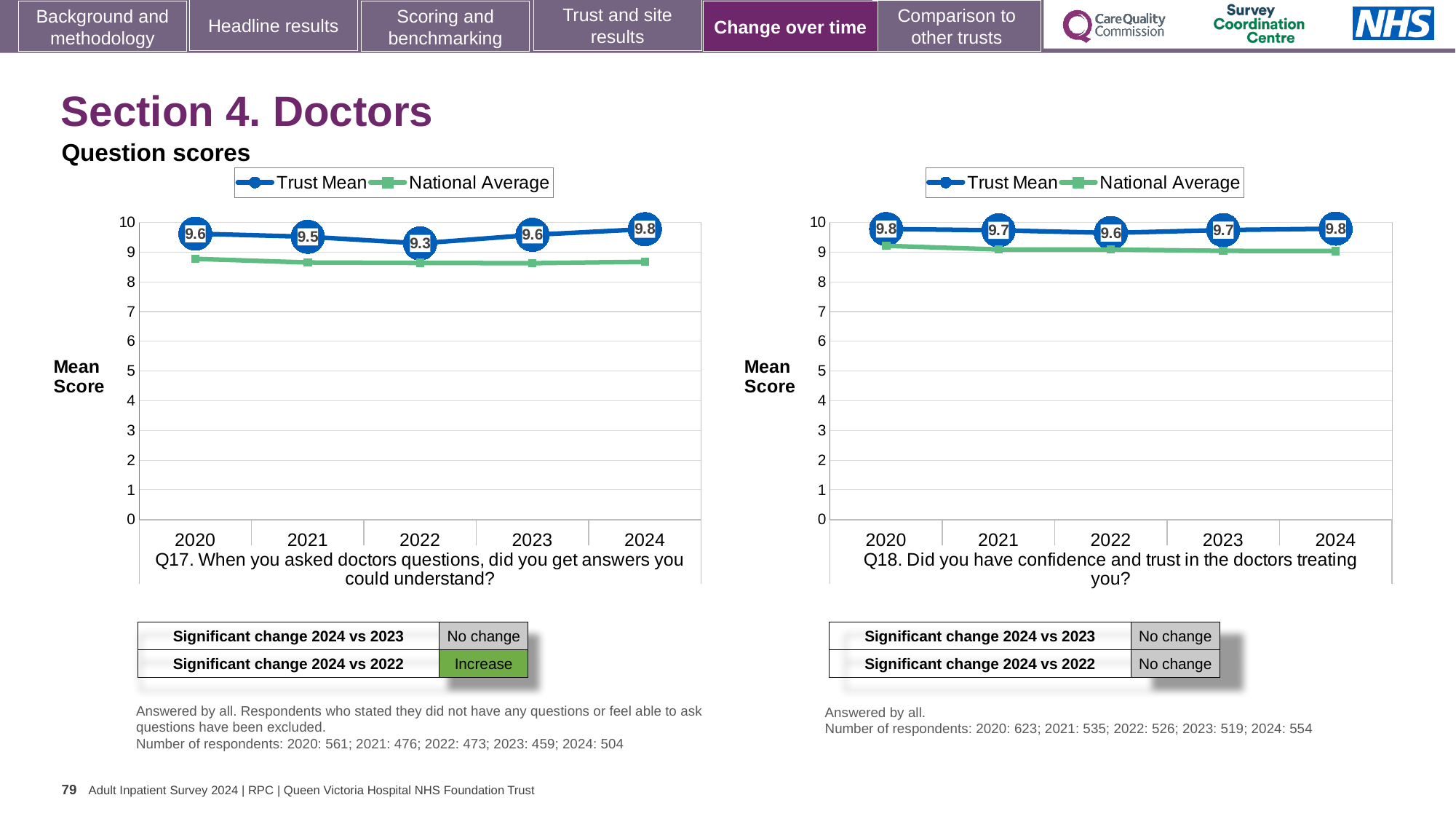
In the Q17 chart (left), is the National Average value for 2020 greater or less than 9? less How many series does the legend of the Q18 chart (right) list? 2 In the Q18 chart (right), what is the Trust Mean score for 2021? 9.7 In the Q18 chart (right), what is the difference between the Trust Mean scores for 2020 and 2022? 0.2 In the Q18 chart (right), is the National Average value for 2020 greater or less than 9? greater In the Q17 chart (left), which year has the lowest Trust Mean score? 2022 In the Q18 chart (right), which year has the lowest Trust Mean score? 2022 In the Q17 chart (left), what is the Trust Mean score for 2022? 9.3 In the Q17 chart (left), what is the Trust Mean score for 2024? 9.8 In the Q17 chart (left), is the Trust Mean score for 2021 higher or lower than the Trust Mean score for 2024? lower In the Q17 chart (left), what is the difference between the Trust Mean scores for 2024 and 2022? 0.5 What type of chart is the Q17 chart (left)? Line chart